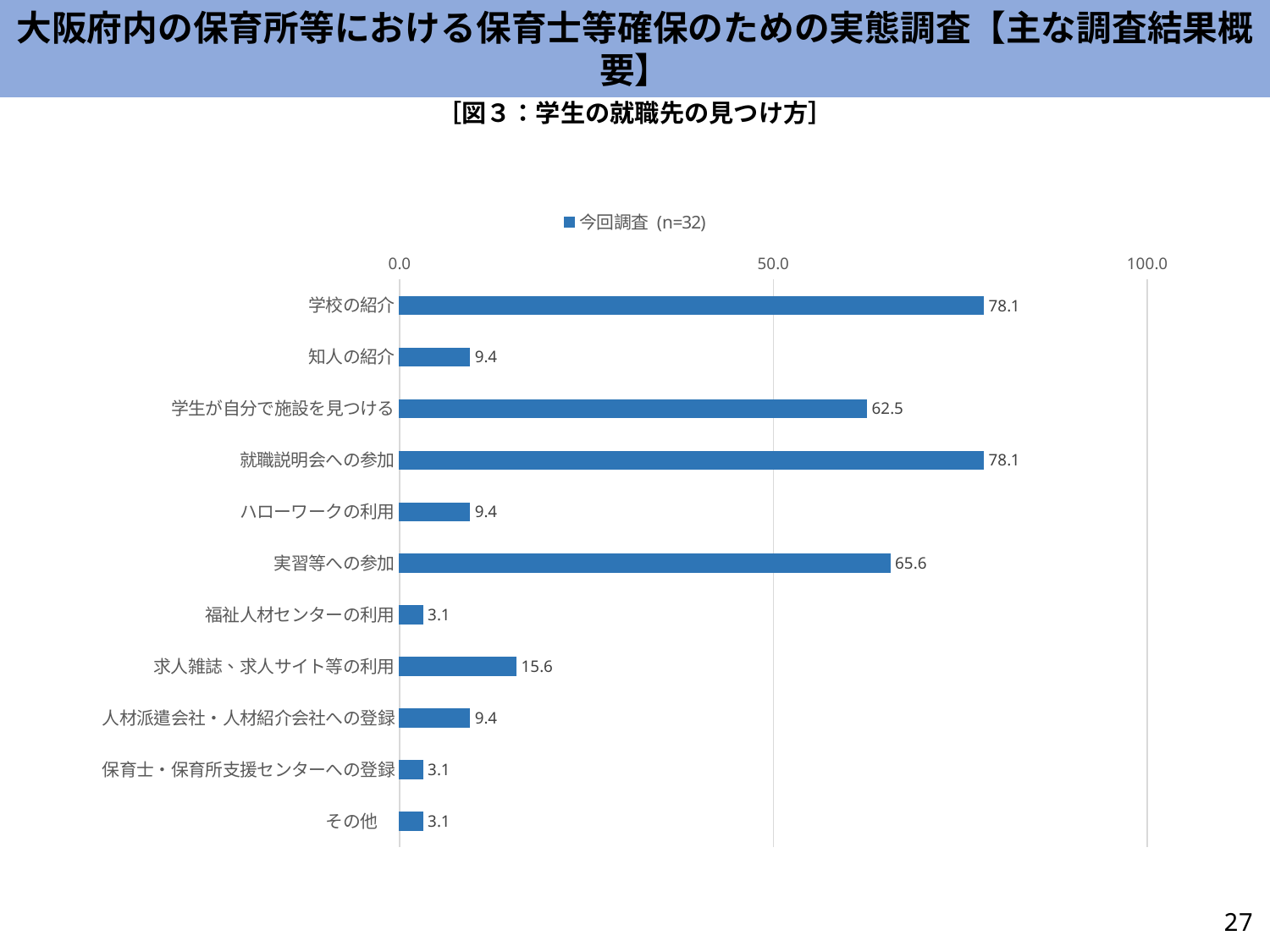
What is the difference between the value for 求人雑誌、求人サイト等の利用 and the value for ハローワークの利用? 6.2 What is the value for 福祉人材センターの利用? 3.1 What is the value for 学校の紹介? 78.1 What is the value for 実習等への参加? 65.6 How many categories are shown in the chart? 11 What is the value for 学生が自分で施設を見つける? 62.5 What is the value for 求人雑誌、求人サイト等の利用? 15.6 Which is larger, the value for 実習等への参加 or the value for 学生が自分で施設を見つける? 実習等への参加 Is the value for 学校の紹介 greater or less than 50.0? greater How many series does the legend list? 1 What kind of chart is shown on the slide? bar chart What is the difference between the value for 就職説明会への参加 and the value for 学生が自分で施設を見つける? 15.6